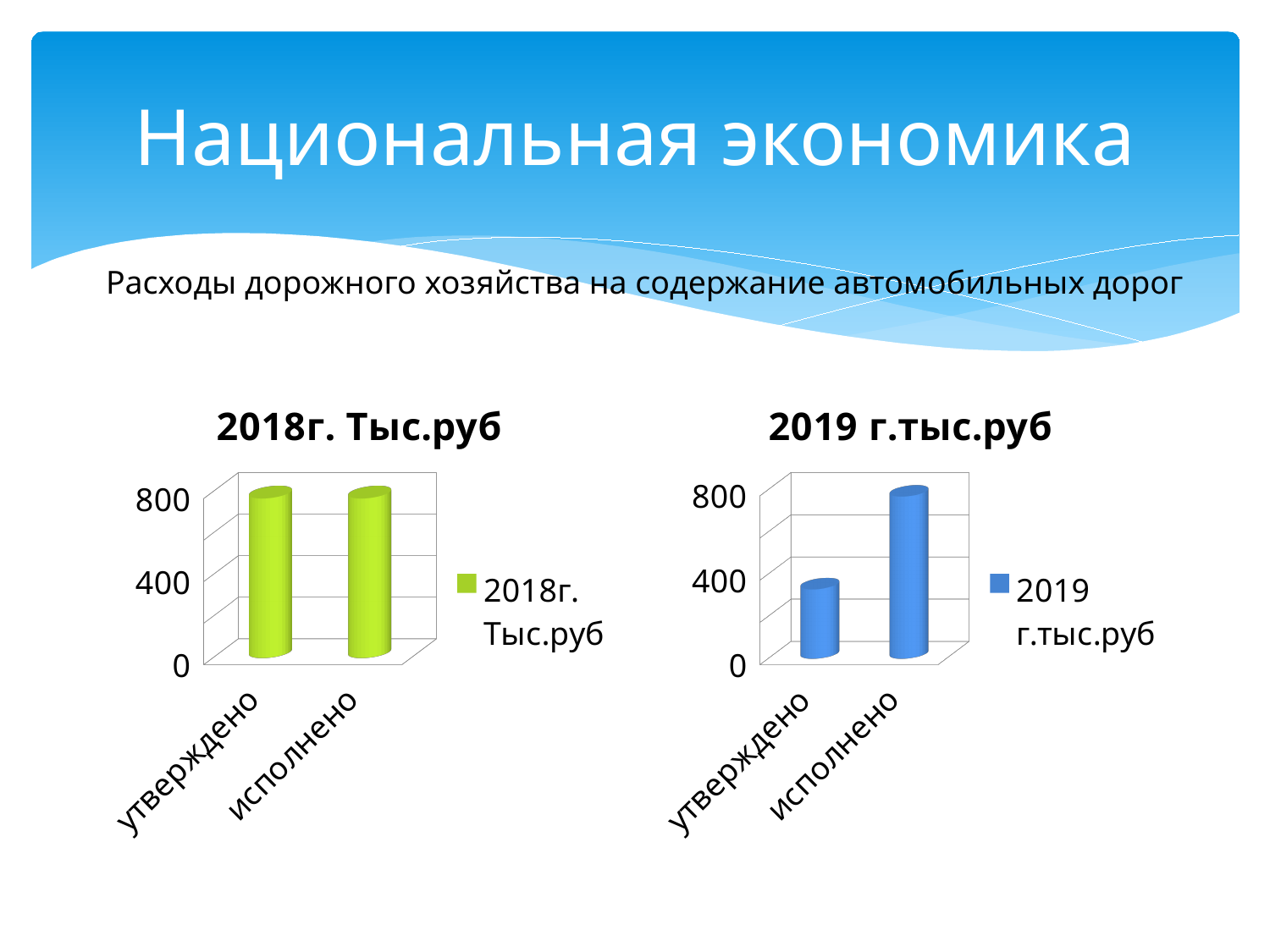
In the chart titled "2019 г.тыс.руб", how many categories are shown on the x axis? 2 What kind of chart is the chart titled "2018г. Тыс.руб"? bar chart In the chart titled "2018г. Тыс.руб", is the value for исполнено greater or less than 400? greater In the chart titled "2019 г.тыс.руб", is the value for утверждено greater or less than 800? less In the chart titled "2019 г.тыс.руб", is the value for исполнено greater or less than 400? greater In the chart titled "2018г. Тыс.руб", how many categories are shown on the x axis? 2 What colour are the bars in the chart titled "2019 г.тыс.руб"? blue What kind of chart is the chart titled "2019 г.тыс.руб"? bar chart In the chart titled "2019 г.тыс.руб", which category has the lowest value? утверждено In the chart titled "2019 г.тыс.руб", which is larger, утверждено or исполнено? исполнено In the chart titled "2018г. Тыс.руб", how many series does the legend list? 1